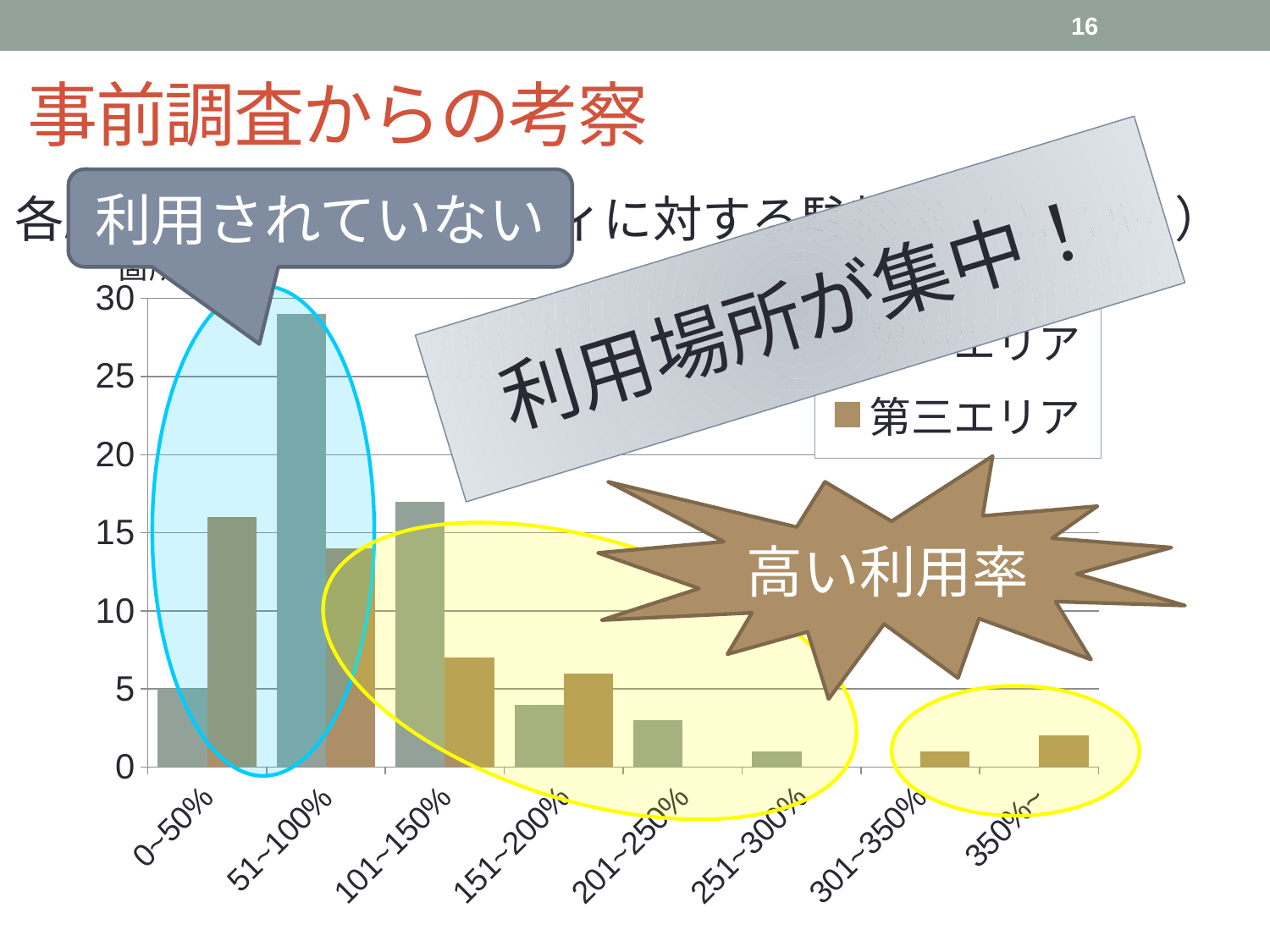
Is the bar in the 251~300% category greater or less than 5? less Which x-axis category contains the tallest bar in the chart? 51~100% Is the tallest bar in the 51~100% category greater or less than 25? greater What kind of chart is shown on the slide? bar chart How many categories are shown on the x axis of the chart? 8 What is the last legend entry readable in the chart's legend? 第三エリア Is the tallest bar in the 201~250% category greater or less than 10? less Which category has a taller tallest bar, 0~50% or 51~100%? 51~100% From the 101~150% category to the 350%~ category, do the bar heights generally rise or fall? fall